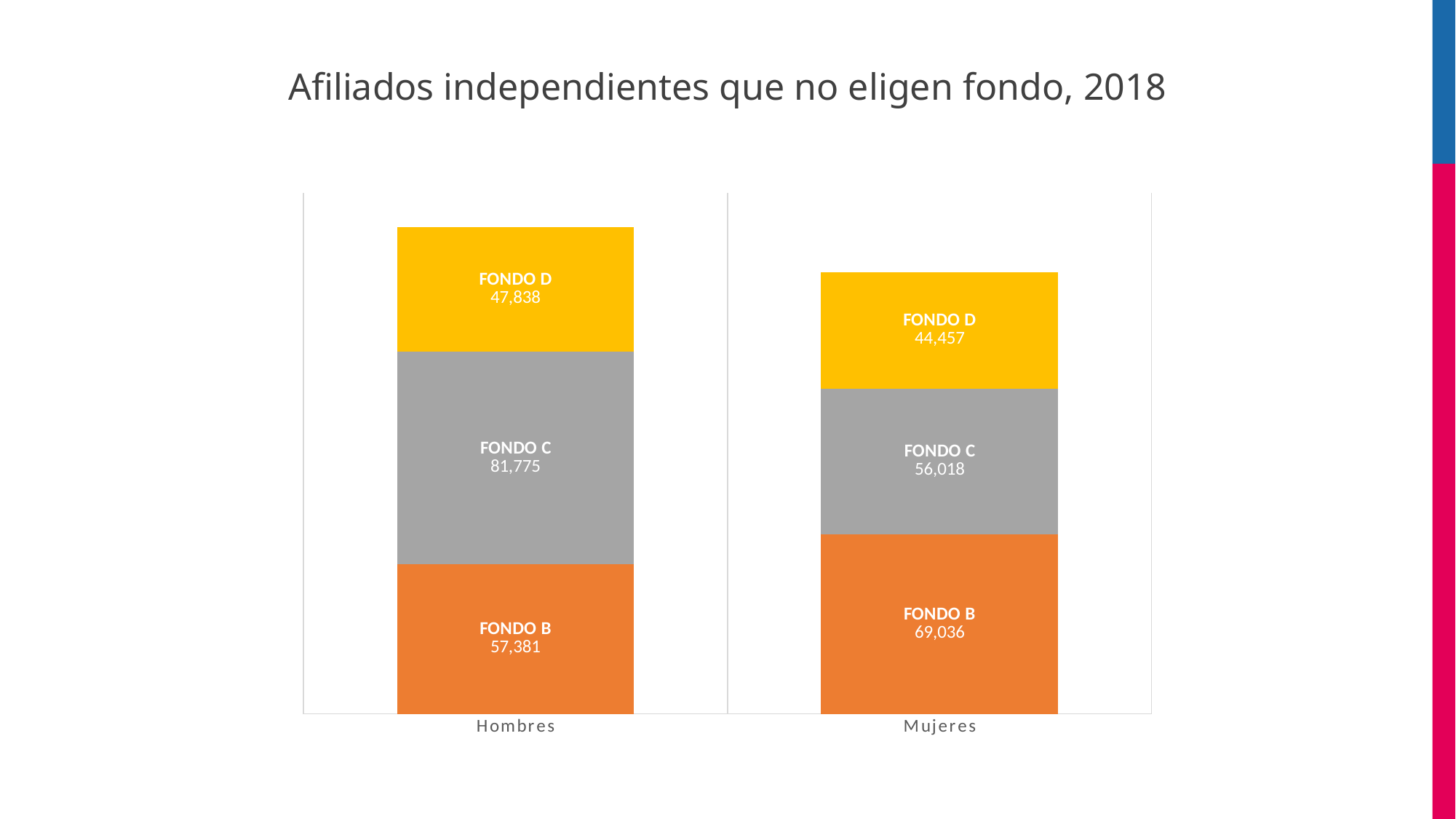
What is the value for FONDO B in the Mujeres bar? 69,036 What kind of chart is shown on the slide? Stacked bar chart What is the value for FONDO D in the Mujeres bar? 44,457 Which fondo has the smallest value in the Mujeres bar? FONDO D What is the difference between the FONDO C values for Hombres and Mujeres? 25,757 Which is larger, FONDO B for Hombres or FONDO B for Mujeres? Mujeres What is the value for FONDO C in the Hombres bar? 81,775 What is the total of the Mujeres stacked bar? 169,511 Which fondo has the largest value in the Hombres bar? FONDO C What is the value for FONDO D in the Hombres bar? 47,838 How many categories are shown on the x axis? 2 What is the total of the Hombres stacked bar? 186,994